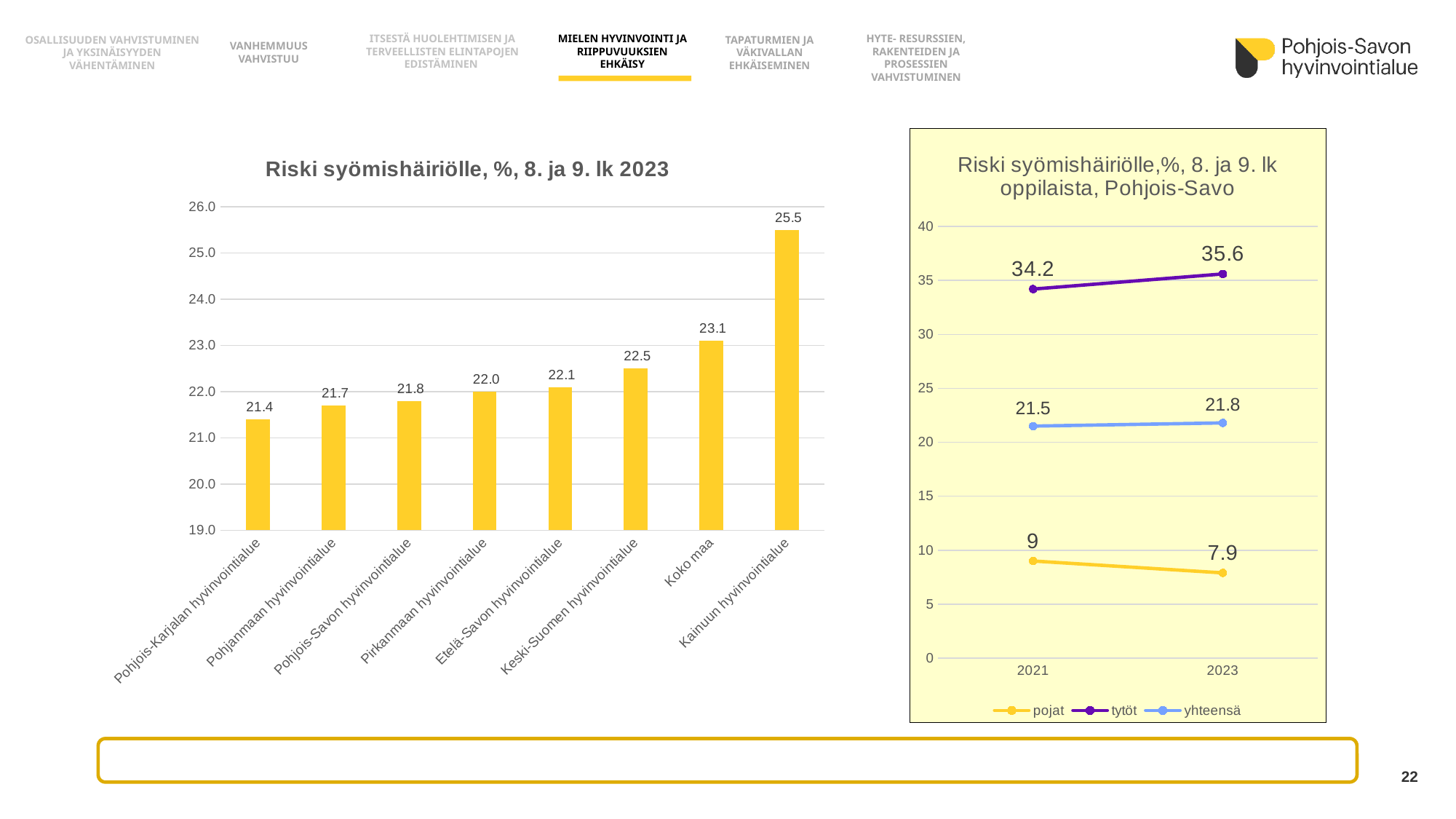
In the line chart 'Riski syömishäiriölle,%, 8. ja 9. lk oppilaista, Pohjois-Savo', does the value for pojat rise or fall from 2021 to 2023? fall In the bar chart 'Riski syömishäiriölle, %, 8. ja 9. lk 2023', what is the difference between Kainuun hyvinvointialue and Pohjois-Savon hyvinvointialue? 3.7 In the bar chart 'Riski syömishäiriölle, %, 8. ja 9. lk 2023', which category has the lowest value? Pohjois-Karjalan hyvinvointialue In the line chart 'Riski syömishäiriölle,%, 8. ja 9. lk oppilaista, Pohjois-Savo', how many series does the legend list? 3 In the bar chart 'Riski syömishäiriölle, %, 8. ja 9. lk 2023', what is the value for Koko maa? 23.1 In the bar chart 'Riski syömishäiriölle, %, 8. ja 9. lk 2023', how many categories are shown? 8 In the bar chart 'Riski syömishäiriölle, %, 8. ja 9. lk 2023', what is the value for Kainuun hyvinvointialue? 25.5 In the bar chart 'Riski syömishäiriölle, %, 8. ja 9. lk 2023', which category has the highest value? Kainuun hyvinvointialue In the bar chart 'Riski syömishäiriölle, %, 8. ja 9. lk 2023', is the value for Keski-Suomen hyvinvointialue greater or less than Koko maa? less What kind of chart is the chart on the left of the slide? bar chart In the line chart 'Riski syömishäiriölle,%, 8. ja 9. lk oppilaista, Pohjois-Savo', what is the value for tytöt in 2023? 35.6 In the line chart 'Riski syömishäiriölle,%, 8. ja 9. lk oppilaista, Pohjois-Savo', what is the value for pojat in 2021? 9